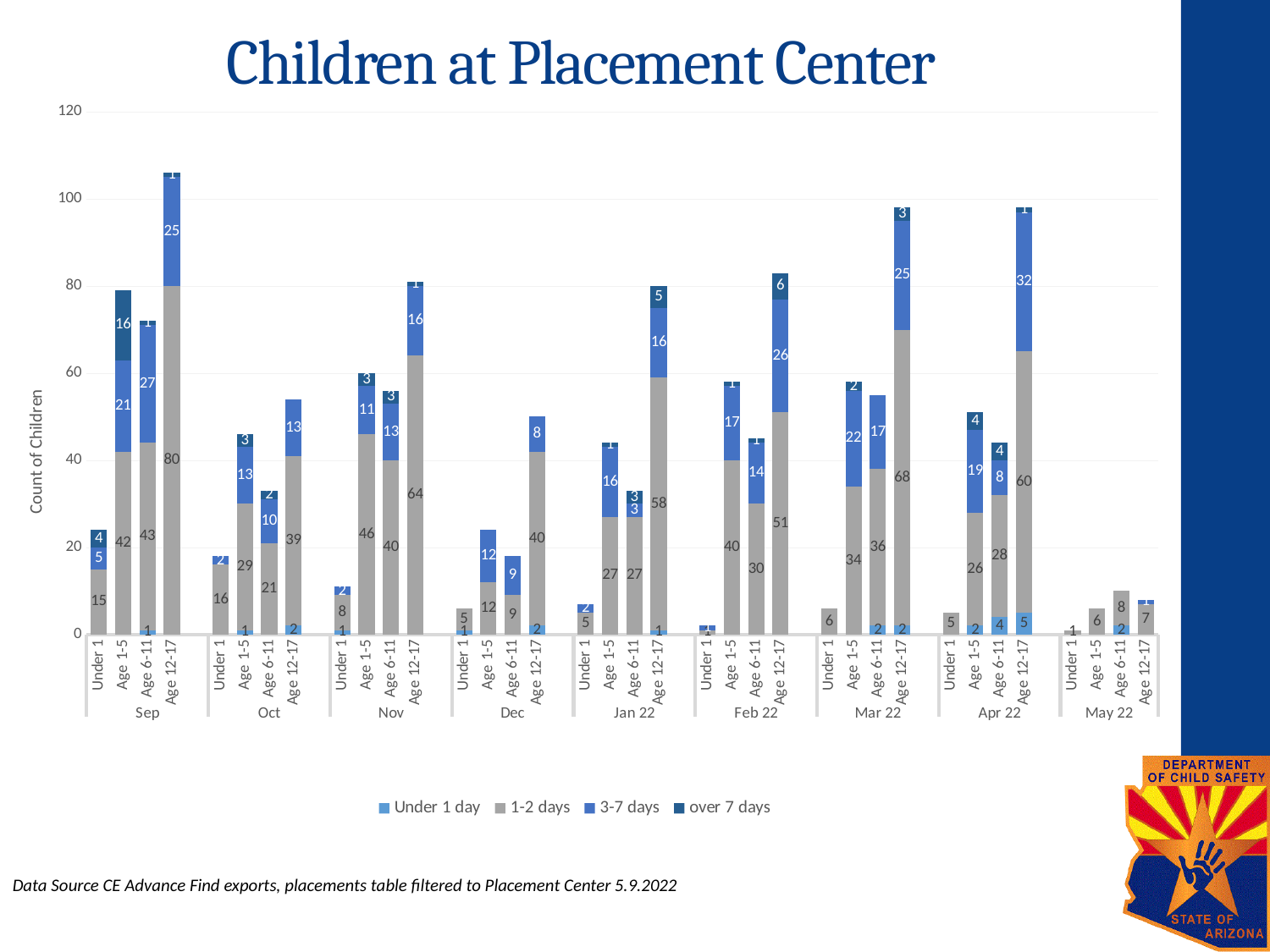
What kind of chart is shown on the slide? stacked bar chart Is the total for Age 12-17 in Sep greater or less than 100? greater What is the total of the stacked bar for Age 12-17 in Feb 22? 83 How many series does the legend list? 4 Which bar is the tallest in the chart? Age 12-17 in Sep What is the difference between the 1-2 days values for Age 12-17 in Mar 22 and Apr 22? 8 What is the 1-2 days value for Age 12-17 in Mar 22? 68 What is the total of the stacked bar for Age 12-17 in Nov? 81 Which is larger: the 1-2 days value for Age 1-5 in Nov or in Feb 22? Nov What is the 3-7 days value for Age 12-17 in Apr 22? 32 What is the 1-2 days value for Age 12-17 in Sep? 80 What is the over 7 days value for Age 1-5 in Sep? 16